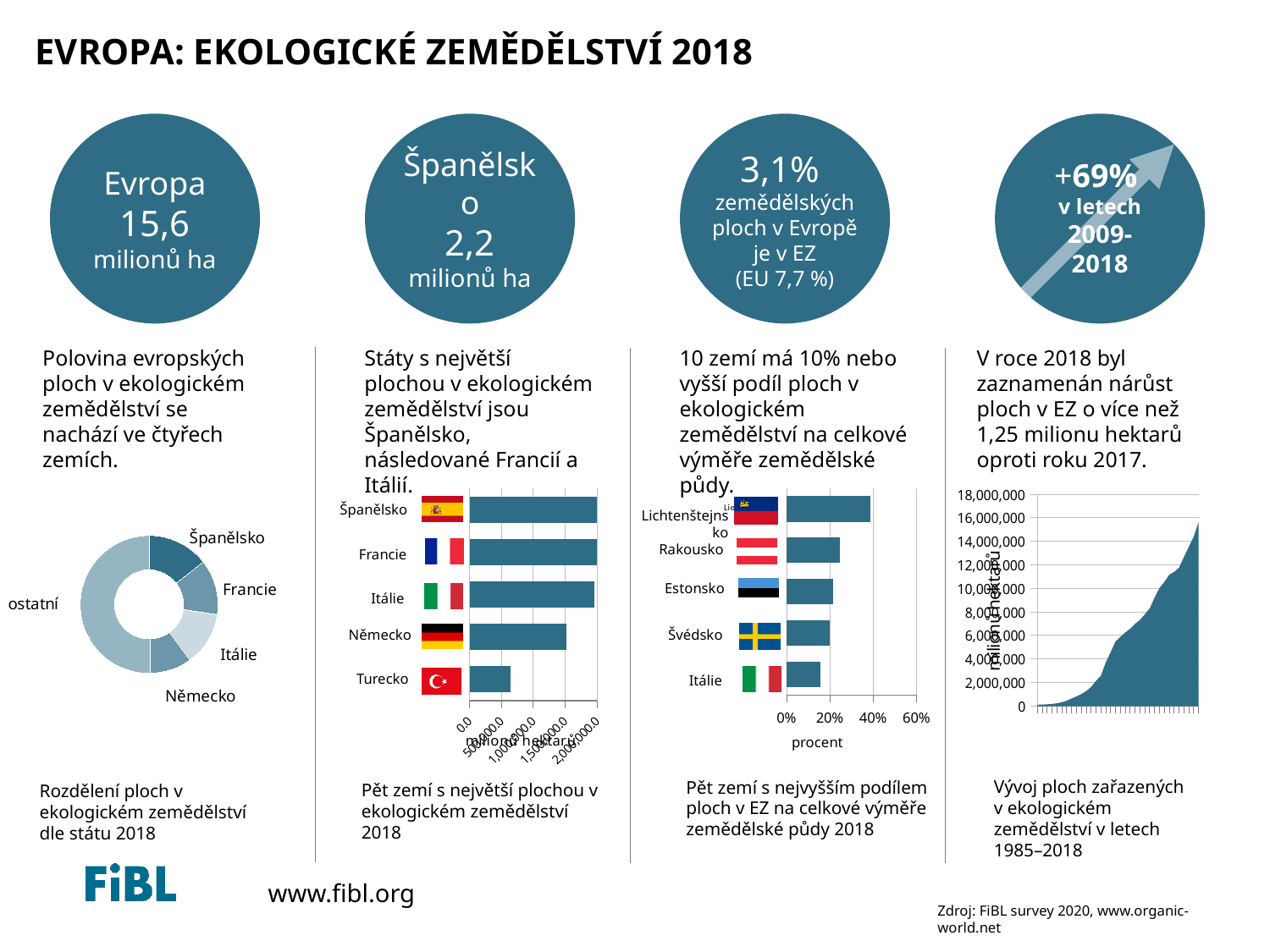
In the chart 'Pět zemí s největší plochou v ekologickém zemědělství 2018', is the value for Turecko greater or less than 1,000,000.0? less What kind of chart is the chart titled 'Rozdělení ploch v ekologickém zemědělství dle státu 2018'? pie chart (donut) How many slices does the chart 'Rozdělení ploch v ekologickém zemědělství dle státu 2018' have? 5 In the chart 'Vývoj ploch zařazených v ekologickém zemědělství v letech 1985–2018', do the values rise or fall over time? rise In the chart 'Pět zemí s největší plochou v ekologickém zemědělství 2018', which country has the smallest area? Turecko In the chart 'Pět zemí s největší plochou v ekologickém zemědělství 2018', which country has the largest area? Španělsko In the chart 'Pět zemí s nejvyšším podílem ploch v EZ na celkové výměře zemědělské půdy 2018', what is the x-axis label? procent In the chart 'Pět zemí s nejvyšším podílem ploch v EZ na celkové výměře zemědělské půdy 2018', which country has the highest share? Lichtenštejnsko In the chart 'Pět zemí s největší plochou v ekologickém zemědělství 2018', which is larger, Německo or Turecko? Německo In the chart 'Rozdělení ploch v ekologickém zemědělství dle státu 2018', which slice is the largest? ostatní What kind of chart is the chart 'Pět zemí s největší plochou v ekologickém zemědělství 2018'? bar chart In the chart 'Pět zemí s nejvyšším podílem ploch v EZ na celkové výměře zemědělské půdy 2018', is the value for Itálie greater or less than 20%? less